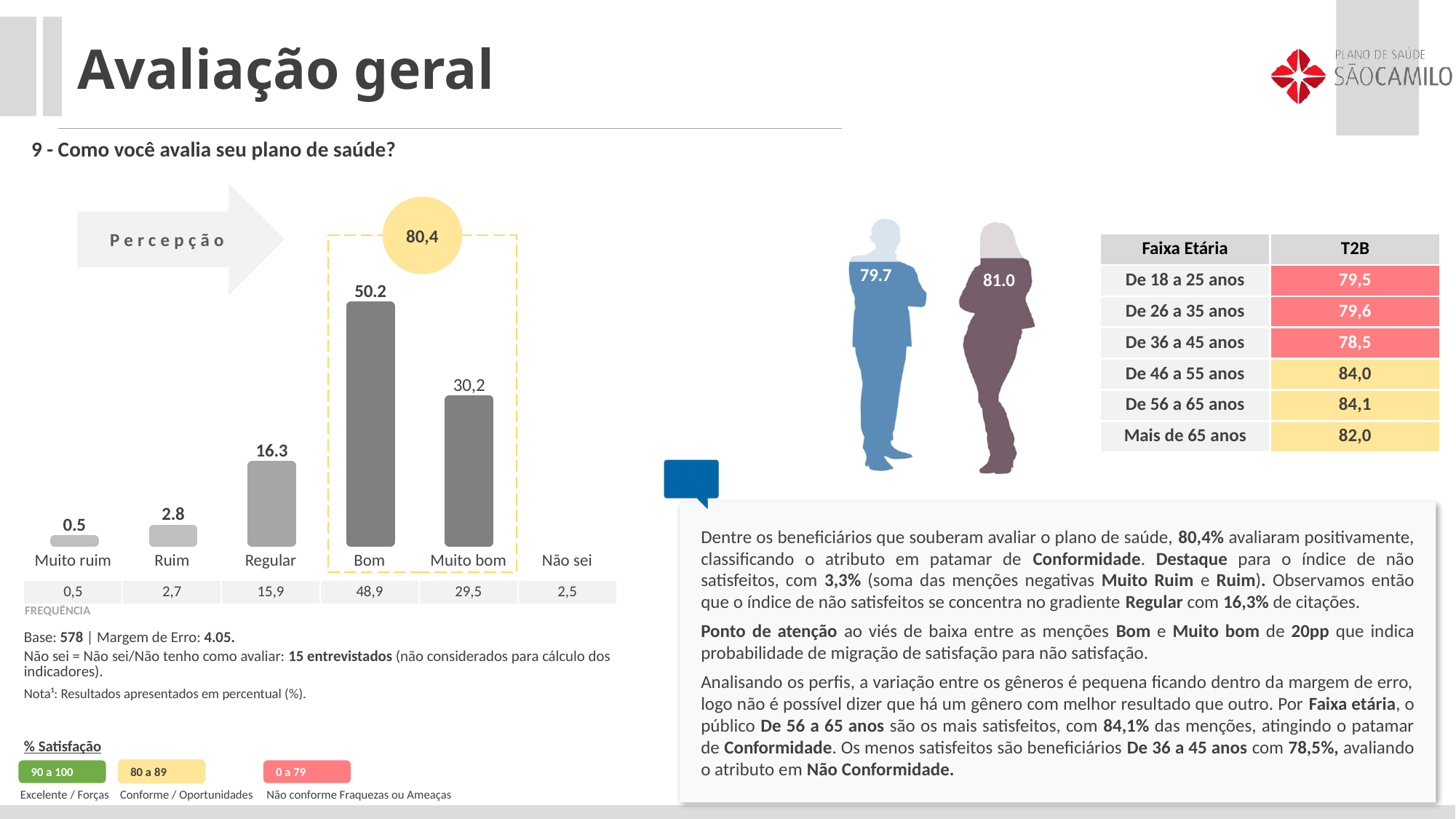
What is the difference between the Regular and Ruim values? 13.5 What is the value shown for the Muito bom bar? 30,2 Which category has the highest bar in the chart? Bom What is the difference between the Bom and Muito bom values? 20.0 What is the value shown for the Muito ruim bar? 0.5 Which category has the lowest bar in the chart? Muito ruim What is the value shown for the Bom bar? 50.2 What is the value shown for the Regular bar? 16.3 What value is shown in the yellow circle above the Bom and Muito bom bars? 80,4 What kind of chart is shown on the slide? Bar chart How many bars are plotted in the chart? 5 Which is larger, the value for Regular or the value for Ruim? Regular